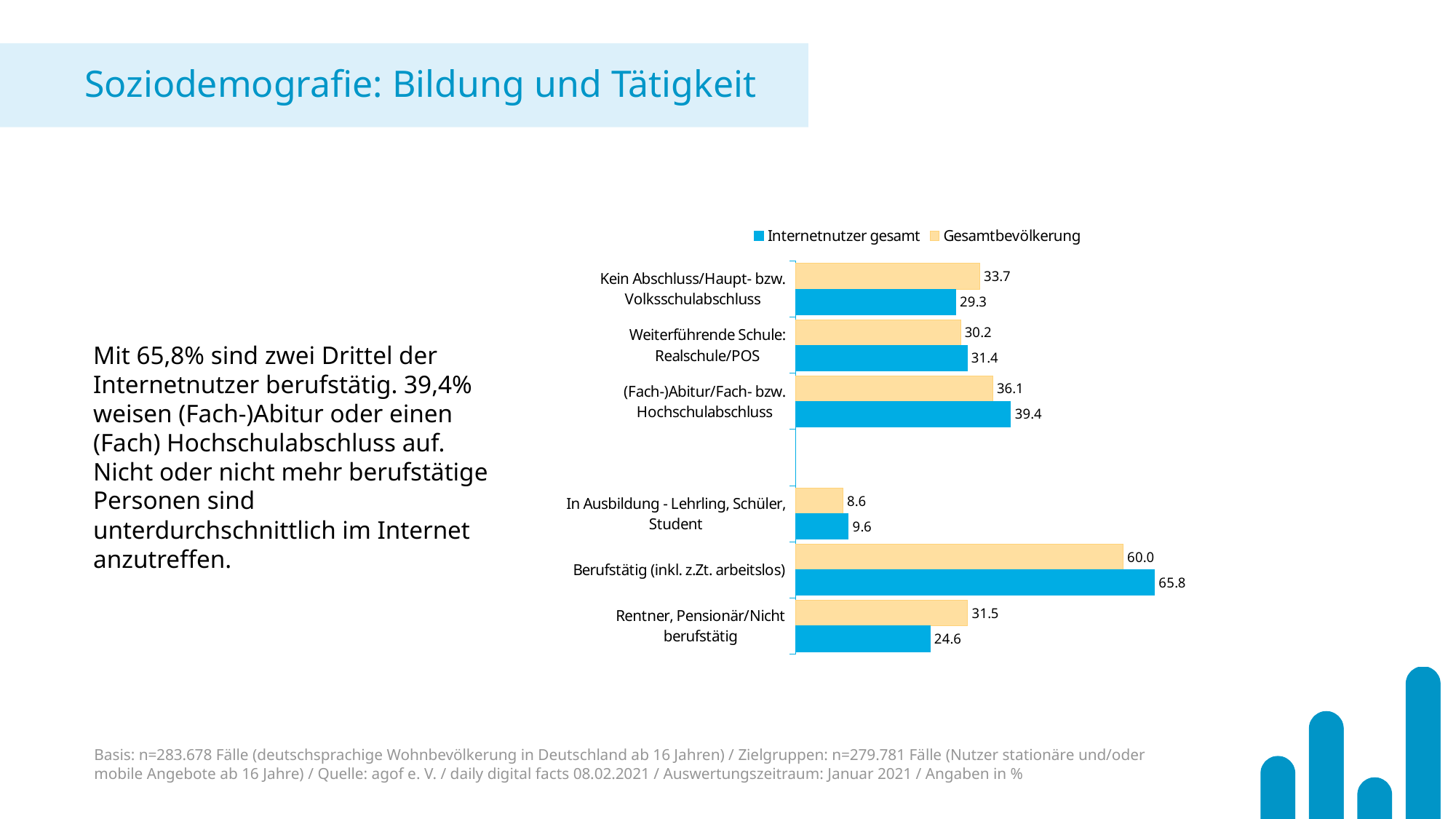
How many categories are shown in the chart? 6 Which category has the highest value for Internetnutzer gesamt? Berufstätig (inkl. z.Zt. arbeitslos) Which category has the lowest value for Gesamtbevölkerung? In Ausbildung - Lehrling, Schüler, Student What is the value for Gesamtbevölkerung in the In Ausbildung - Lehrling, Schüler, Student category? 8.6 What is the difference between Internetnutzer gesamt and Gesamtbevölkerung in the Berufstätig (inkl. z.Zt. arbeitslos) category? 5.8 What kind of chart is shown on the slide? Bar chart What is the value for Gesamtbevölkerung in the Kein Abschluss/Haupt- bzw. Volksschulabschluss category? 33.7 Which colour represents the Gesamtbevölkerung series in the chart? Yellow What is the value for Internetnutzer gesamt in the Berufstätig (inkl. z.Zt. arbeitslos) category? 65.8 What is the value for Internetnutzer gesamt in the Rentner, Pensionär/Nicht berufstätig category? 24.6 In the Rentner, Pensionär/Nicht berufstätig category, which series has the larger value: Internetnutzer gesamt or Gesamtbevölkerung? Gesamtbevölkerung How many series does the legend list? 2